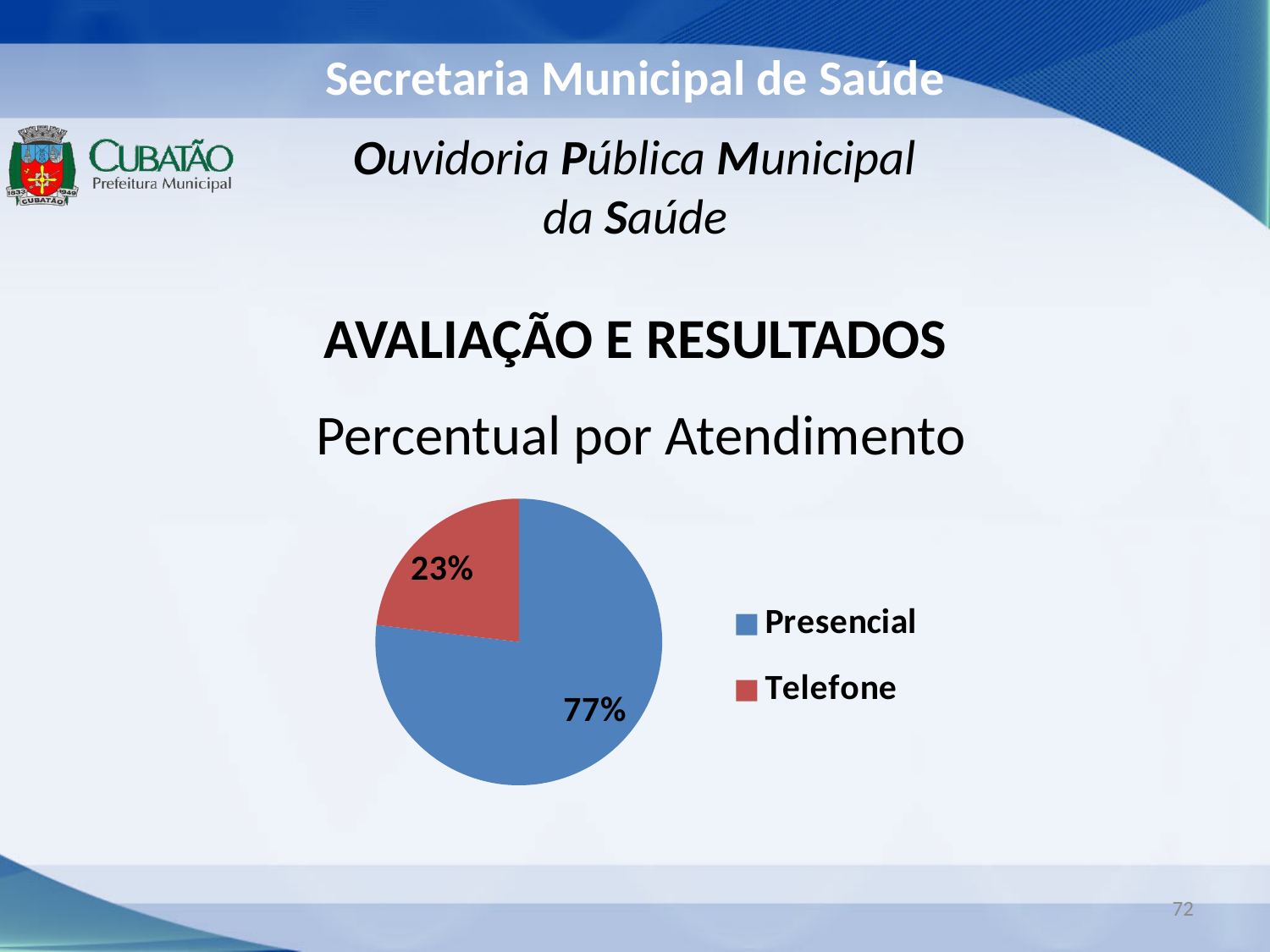
What colour is the Telefone slice in the pie chart? red What percentage of the pie chart is Telefone? 23% What percentage of the pie chart is Presencial? 77% Which category has the smallest share of the pie chart? Telefone What kind of chart is shown on the slide? pie chart What is the title of the chart? Percentual por Atendimento How many categories does the pie chart show? 2 Which is larger, the share for Presencial or the share for Telefone? Presencial Which category has the largest share of the pie chart? Presencial What is the share of the pie taken by the Presencial slice? 77% What is the difference in percentage points between Presencial and Telefone? 54